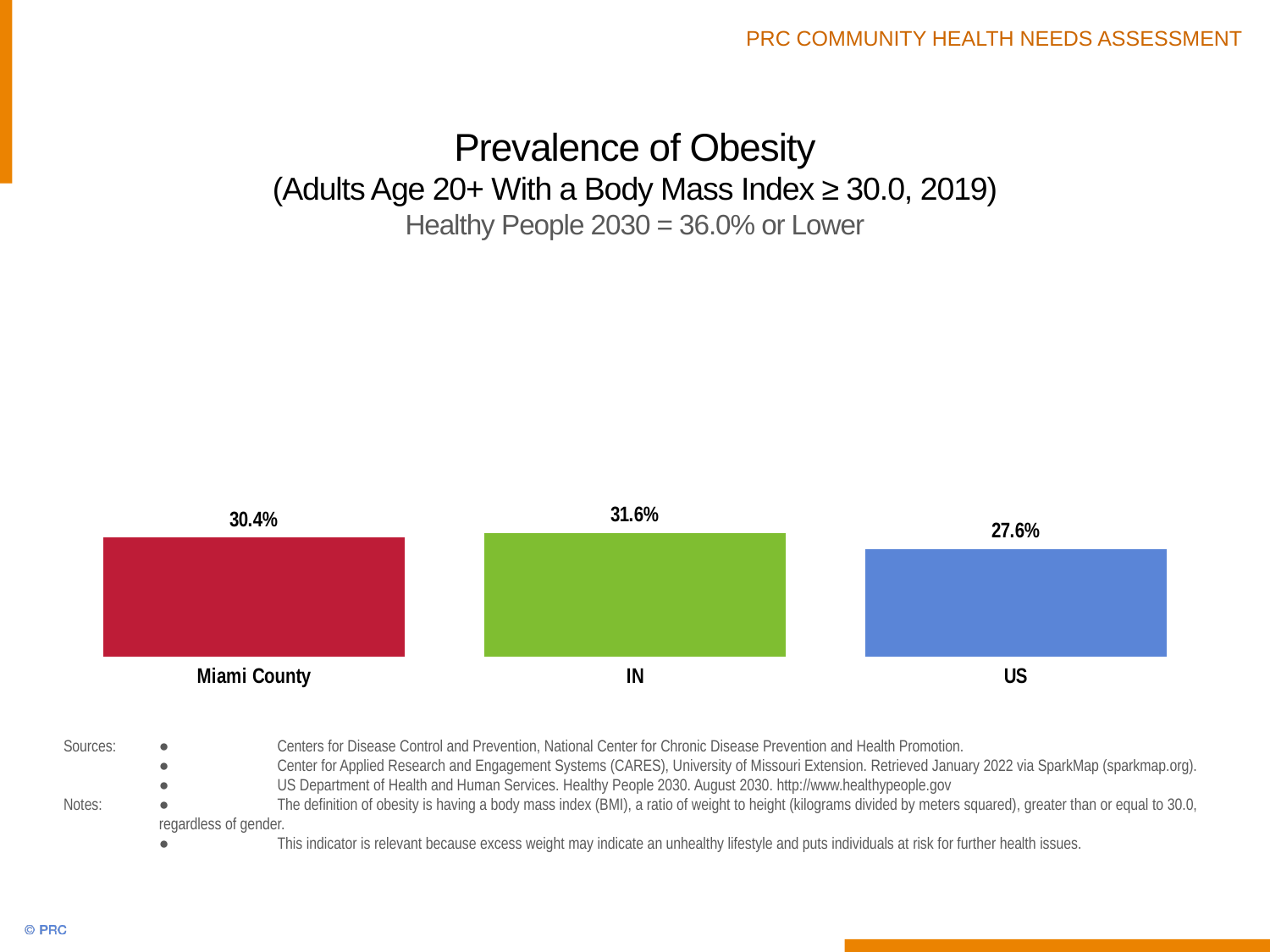
What kind of chart is shown on the slide? Bar chart How many categories are shown in the chart? 3 What is the prevalence of obesity for US? 27.6% What is the prevalence of obesity for Miami County? 30.4% What is the difference between the IN value and the Miami County value? 1.2% What is the prevalence of obesity for IN? 31.6% Which category has the lowest prevalence of obesity? US Which category has the highest prevalence of obesity? IN What is the Healthy People 2030 target stated in the chart subtitle? 36.0% or Lower What colour is the bar for IN? Green Which is larger, the value for Miami County or the value for US? Miami County What is the difference between the Miami County value and the US value? 2.8%